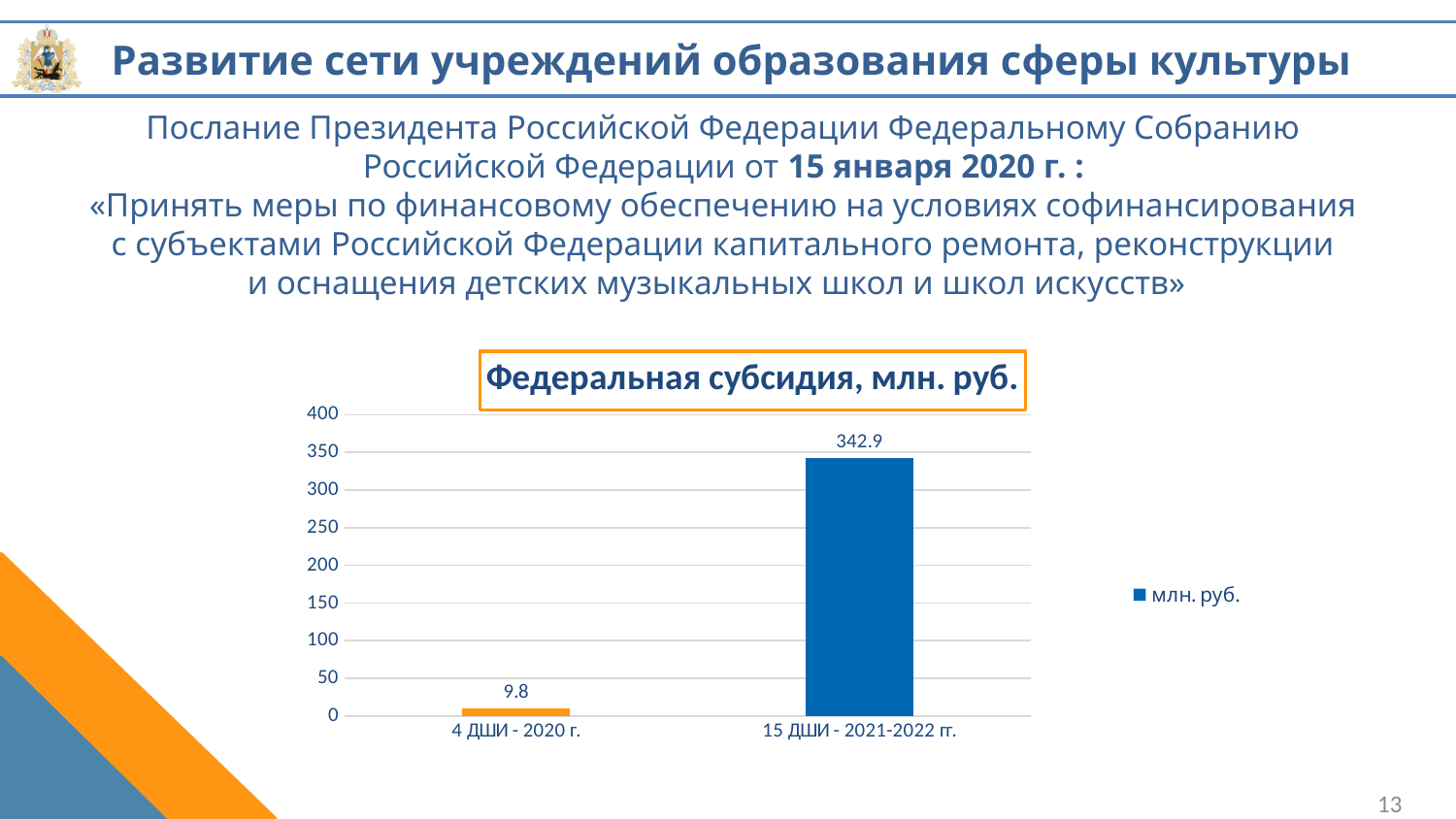
How many series does the legend list? 1 What is the value for "15 ДШИ - 2021-2022 гг."? 342.9 What kind of chart is shown on the slide? bar chart Which is larger: the value for "4 ДШИ - 2020 г." or the value for "15 ДШИ - 2021-2022 гг."? 15 ДШИ - 2021-2022 гг. Is the value for "15 ДШИ - 2021-2022 гг." greater or less than 300? greater What is the title of the chart? Федеральная субсидия, млн. руб. What is the value for "4 ДШИ - 2020 г."? 9.8 How many categories are shown on the chart? 2 Which category has the highest value? 15 ДШИ - 2021-2022 гг. Is the value for "4 ДШИ - 2020 г." greater or less than 50? less Which category has the lowest value? 4 ДШИ - 2020 г. What is the difference between the values for "15 ДШИ - 2021-2022 гг." and "4 ДШИ - 2020 г."? 333.1